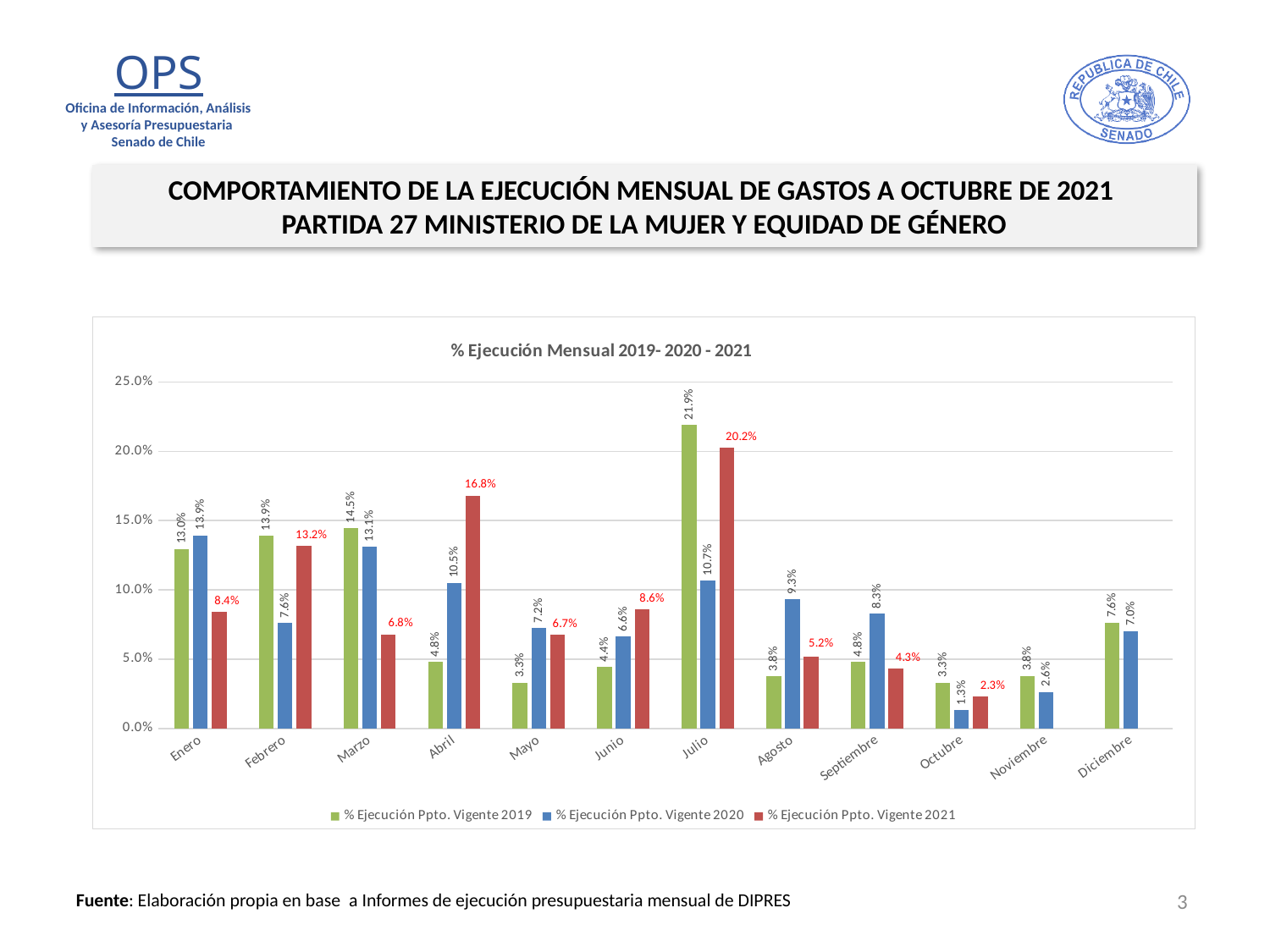
What is the value of % Ejecución Ppto. Vigente 2020 for Julio? 10.7% What is the value of % Ejecución Ppto. Vigente 2019 for Marzo? 14.5% What is the difference between the 2019 and 2021 values for Julio? 1.7% What is the value of % Ejecución Ppto. Vigente 2021 for Abril? 16.8% In which month is the % Ejecución Ppto. Vigente 2020 value lowest? Octubre What type of chart is shown on the slide? Bar chart In which month is the % Ejecución Ppto. Vigente 2019 value highest? Julio Is the % Ejecución Ppto. Vigente 2021 value for Julio greater or less than 20.0%? greater How many months are shown on the x axis? 12 For Enero, which is larger: the 2019 value or the 2020 value? 2020 What is the title of the chart? % Ejecución Mensual 2019- 2020 - 2021 How many series does the legend list? 3